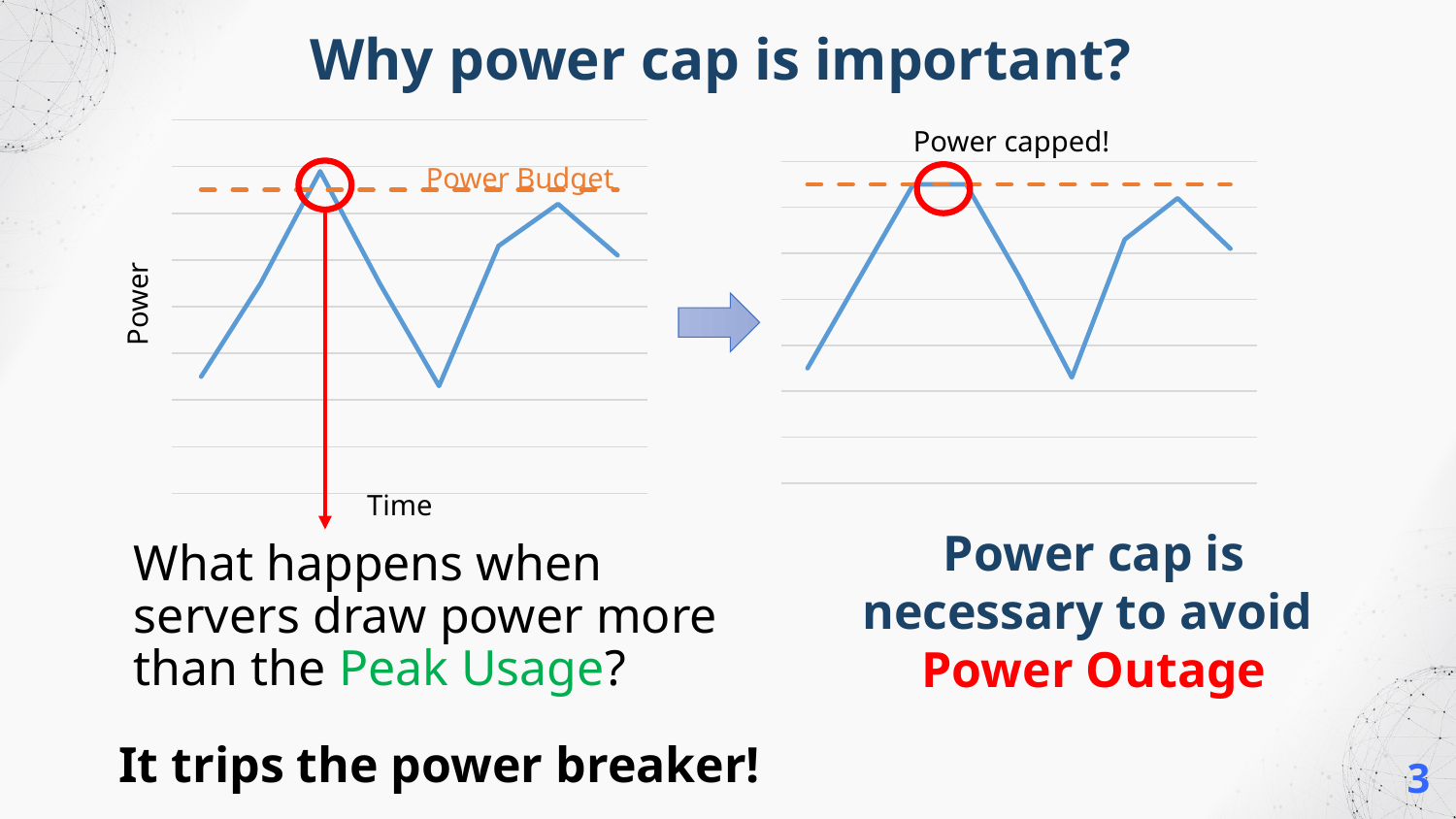
On the left chart, does the blue line rise or fall between the first peak and the following trough? fall On the left chart, what does the dashed orange line represent? Power Budget What kind of chart is the left chart? line chart On the right chart, does the blue line rise above the dashed line? no What kind of chart is the right chart (labelled 'Power capped!')? line chart On the right chart, is the first (capped) peak higher or lower than the second peak? higher On the left chart, what is the label of the x axis? Time On the right chart, does the blue line rise or fall from the second peak to its final point? fall On the left chart, does the blue line rise above the dashed Power Budget line? yes On the left chart, does the blue line rise or fall from its starting point to its first peak? rise